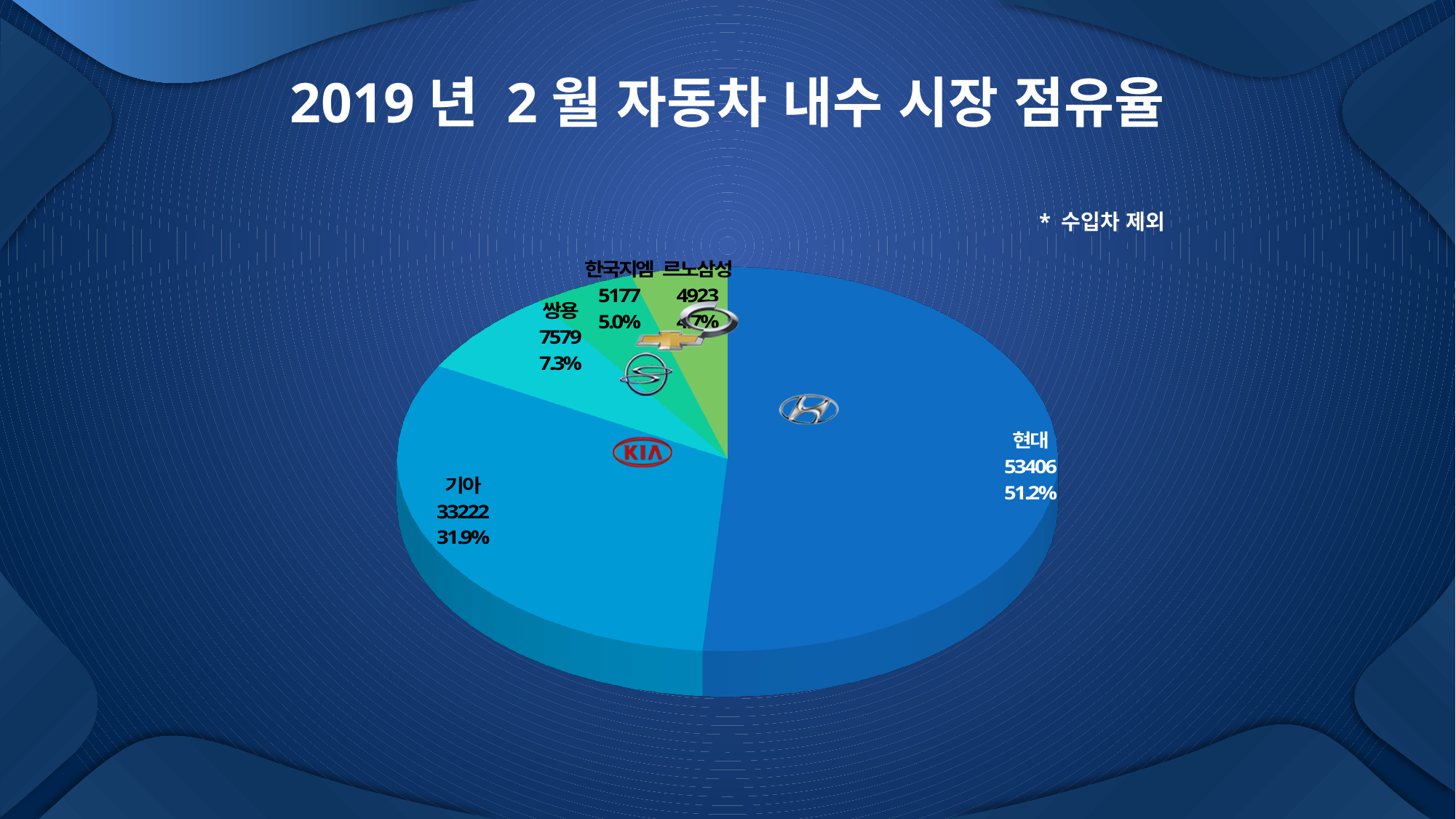
Which brand has the largest slice of the pie? 현대 What is the value shown for 기아? 33222 What is the difference between the values for 현대 and 기아? 20184 What share of the pie does 기아 hold? 31.9% Which brand has the smallest slice of the pie? 르노삼성 How many slices does the pie chart have? 5 What is the value shown for 현대? 53406 What share of the pie does 한국지엠 hold? 5.0% What share of the pie does 현대 hold? 51.2% What is the value shown for 쌍용? 7579 What kind of chart is shown on the slide? Pie chart What is the title of the chart? 2019년 2월 자동차 내수 시장 점유율